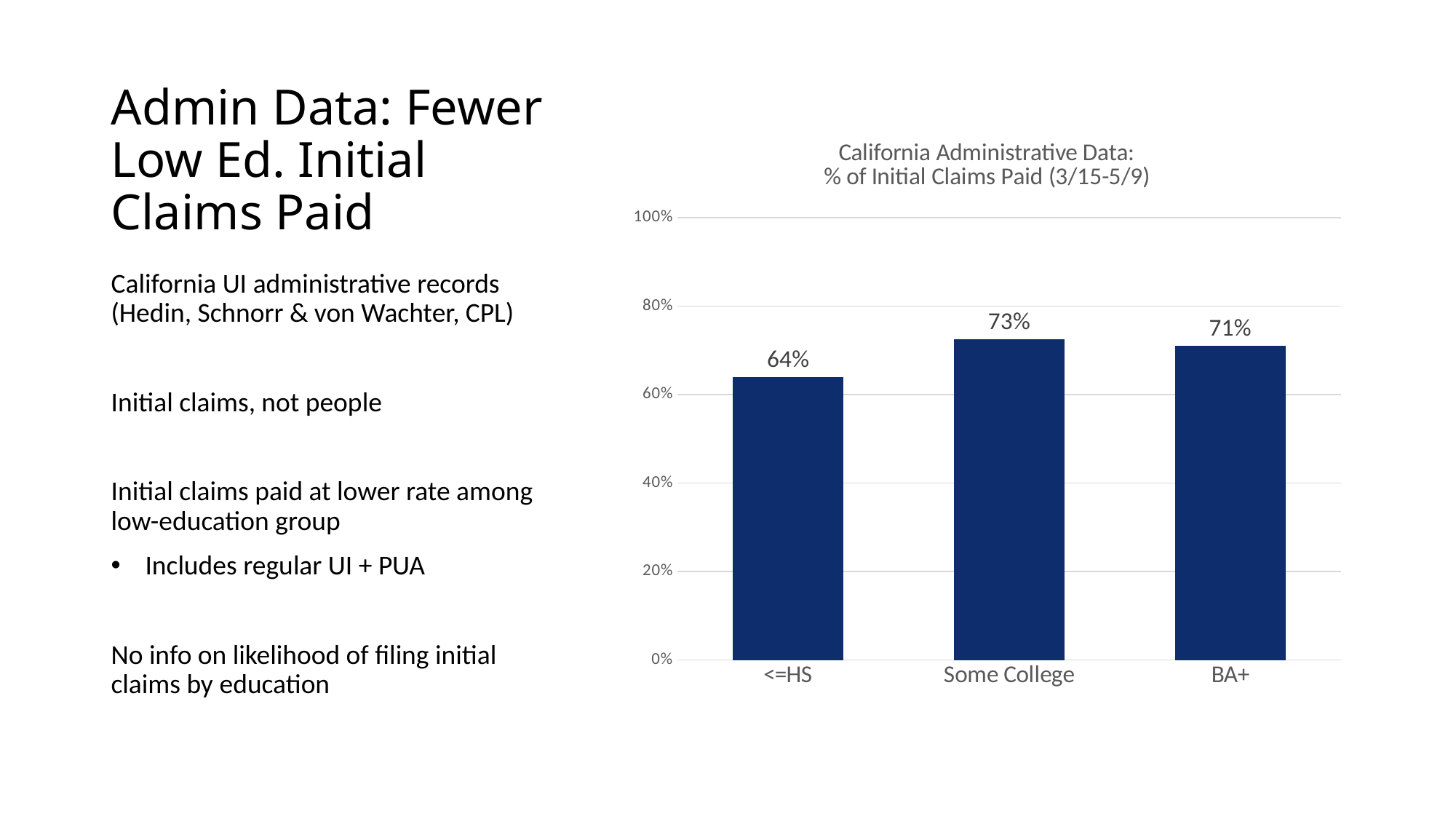
What is the title of the chart? California Administrative Data: % of Initial Claims Paid (3/15-5/9) Which is larger, the value for BA+ or the value for <=HS? BA+ What is the value for <=HS? 64% Which category has the highest % of initial claims paid? Some College What is the value for BA+? 71% What is the value for Some College? 73% Is the value for <=HS greater or less than 80%? less Which category has the lowest % of initial claims paid? <=HS How many categories are shown on the x axis? 3 What is the difference between the values for Some College and <=HS? 9% What is the difference between the values for BA+ and <=HS? 7% What kind of chart is shown on the slide? bar chart